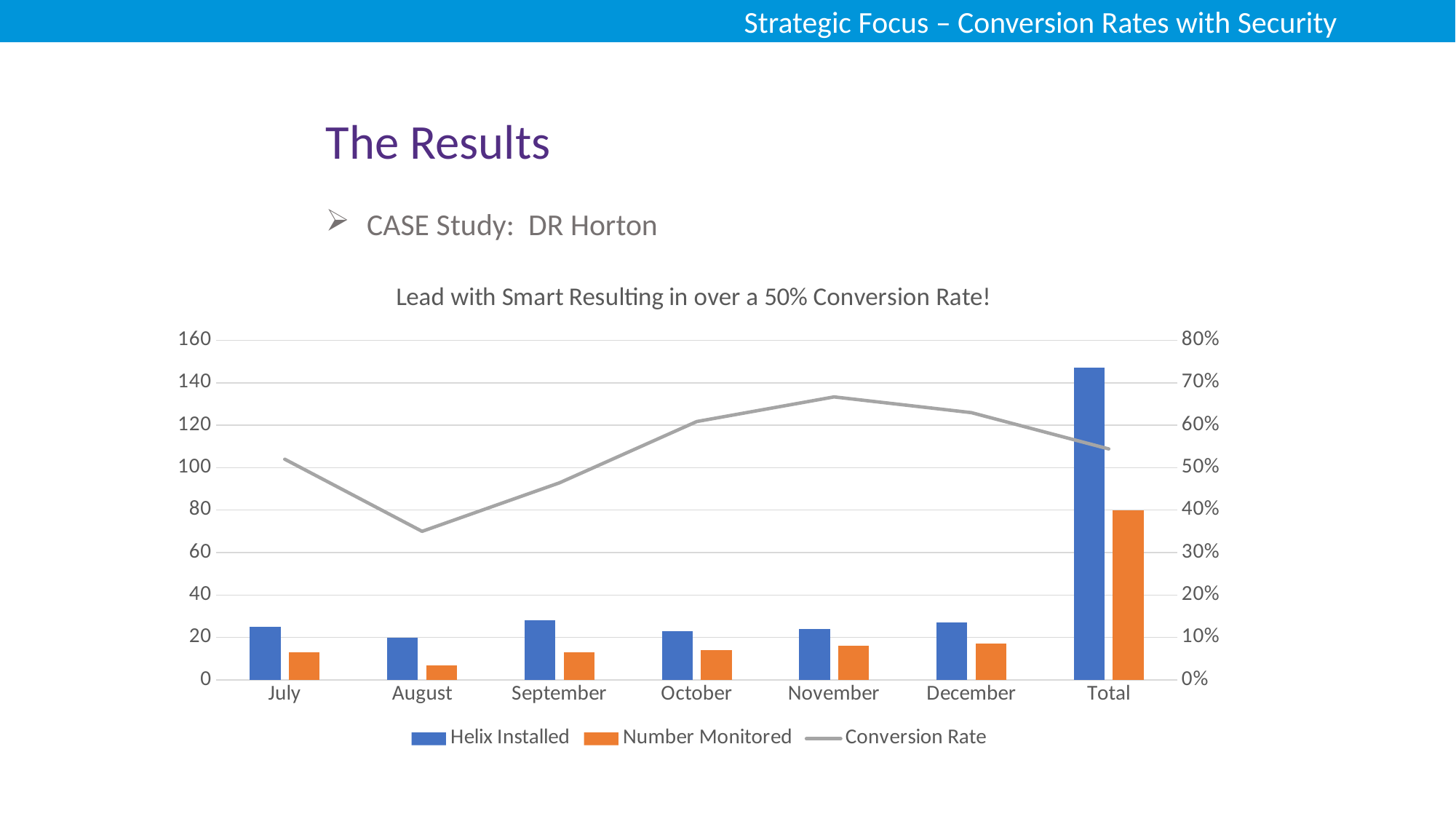
What is the title of the chart? Lead with Smart Resulting in over a 50% Conversion Rate! What kind of chart is shown on the slide? A combination bar and line chart Which category has the highest Helix Installed bar? Total Which is larger, Helix Installed in September or Helix Installed in August? September How many series does the chart legend list? 3 How many categories are shown along the x axis of the chart? 7 Which category has the lowest Conversion Rate? August Is the Conversion Rate for August greater or less than 40%? less Among the months, which has the highest Conversion Rate? November Which month has the lowest Number Monitored bar? August Is the Helix Installed value for Total greater or less than 140? greater Does the Conversion Rate line rise or fall from August to November? It rises